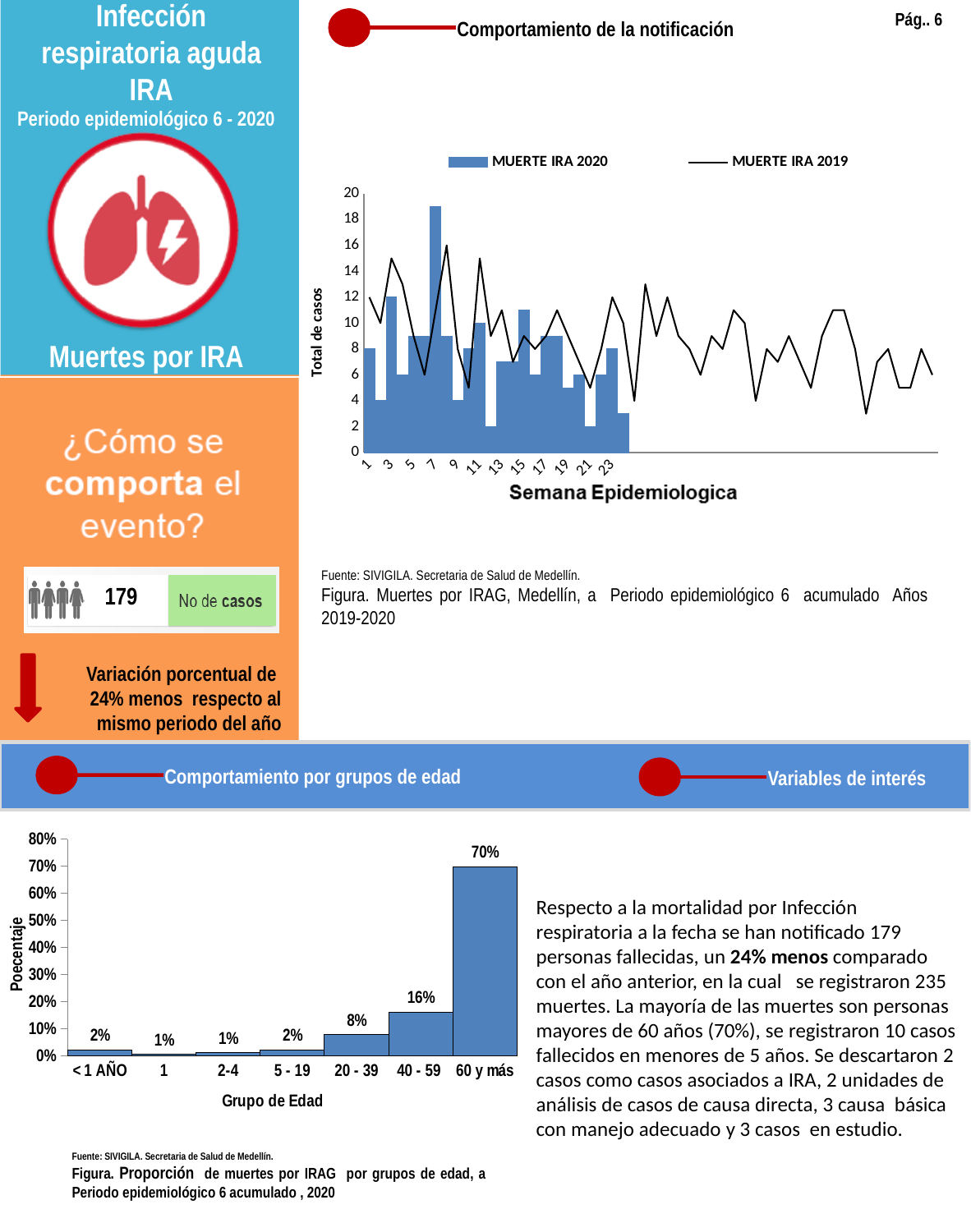
In the top chart (Muertes por IRAG, Medellín, 2019-2020), is the MUERTE IRA 2020 value for week 7 greater or less than 16? greater What kind of chart is the bottom-left chart (Proporción de muertes por IRAG por grupos de edad)? Bar chart How many series does the legend of the top chart (Muertes por IRAG, Medellín, 2019-2020) list? 2 In the bottom-left chart (Proporción de muertes por IRAG por grupos de edad), which is larger, the value for '20 - 39' or for '40 - 59'? 40 - 59 In the bottom-left chart (Proporción de muertes por IRAG por grupos de edad), what is the difference between the '60 y más' and '40 - 59' values? 54% In the top chart (Muertes por IRAG, Medellín, 2019-2020), which series is drawn as a black line? MUERTE IRA 2019 How many age groups are shown on the x axis of the bottom-left chart (Proporción de muertes por IRAG por grupos de edad)? 7 In the bottom-left chart (Proporción de muertes por IRAG por grupos de edad), what is the value for the '60 y más' age group? 70% In the bottom-left chart (Proporción de muertes por IRAG por grupos de edad), what is the value for the '20 - 39' age group? 8% In the bottom-left chart (Proporción de muertes por IRAG por grupos de edad), which age group has the highest percentage? 60 y más In the bottom-left chart (Proporción de muertes por IRAG por grupos de edad), what is the value for the '40 - 59' age group? 16% In the top chart (Muertes por IRAG, Medellín, 2019-2020), which epidemiological week has the highest MUERTE IRA 2020 bar? 7